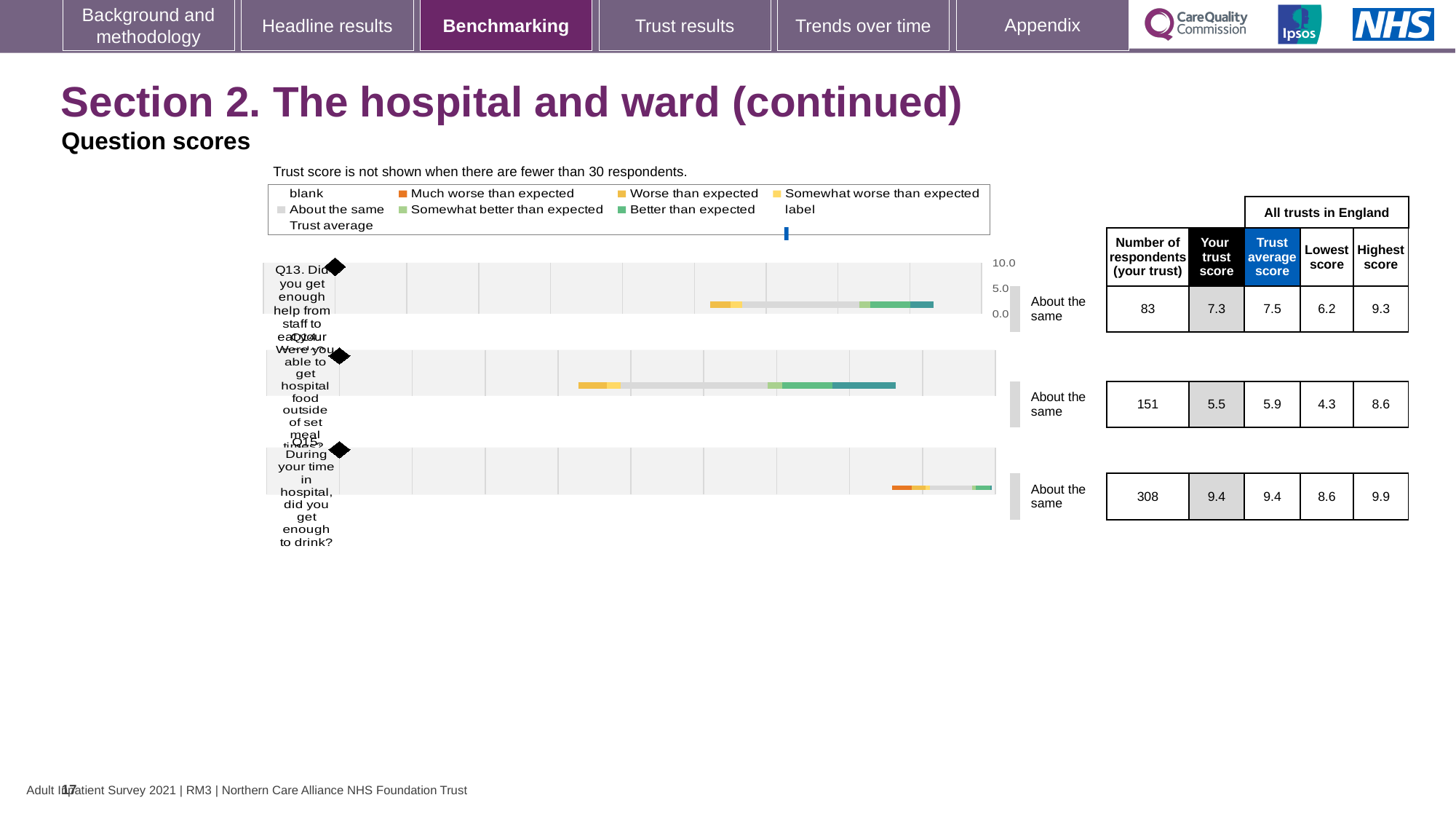
Which question has the highest 'Your trust score'? Q15 For Q13, how much higher is the trust average score than the trust's own score? 0.2 What colour does the legend use for 'Much worse than expected'? Orange Which question has the lowest 'Your trust score'? Q14 What is the 'Your trust score' for Q13 (Did you get enough help from staff to eat your meals?)? 7.3 What benchmark category is shown for Q14? About the same What is the lowest score across all trusts in England for Q14? 4.3 What kind of chart is used to show the question scores? Bar chart How many questions are shown on the chart? 3 How many respondents from the trust answered Q14 (Were you able to get hospital food outside of set meal times?)? 151 For Q14, which is larger: the trust's own score or the trust average score? Trust average score What is the trust average score for Q15 (During your time in hospital, did you get enough to drink?)? 9.4